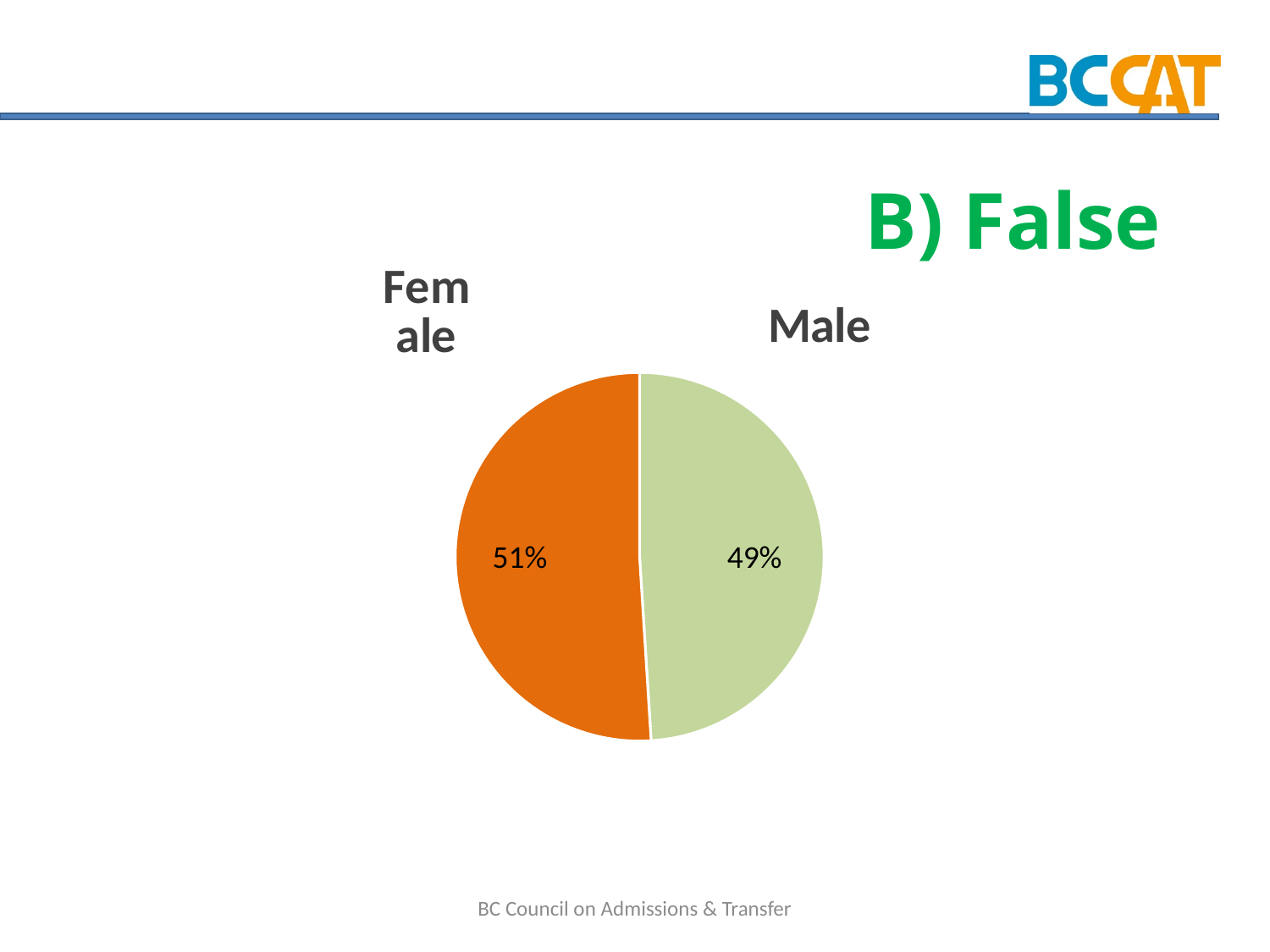
What kind of chart is shown on the slide? pie chart Which slice is larger, Female or Male? Female Is the share for Male greater or less than 50%? less How many slices does the pie chart have? 2 Which category has the largest share of the pie? Female What is the difference in percentage points between the Female and Male slices? 2 What percentage of the pie is Female? 51% Which category has the smallest share of the pie? Male What percentage of the pie is Male? 49% What colour is the Female slice? orange What colour is the Male slice? light green